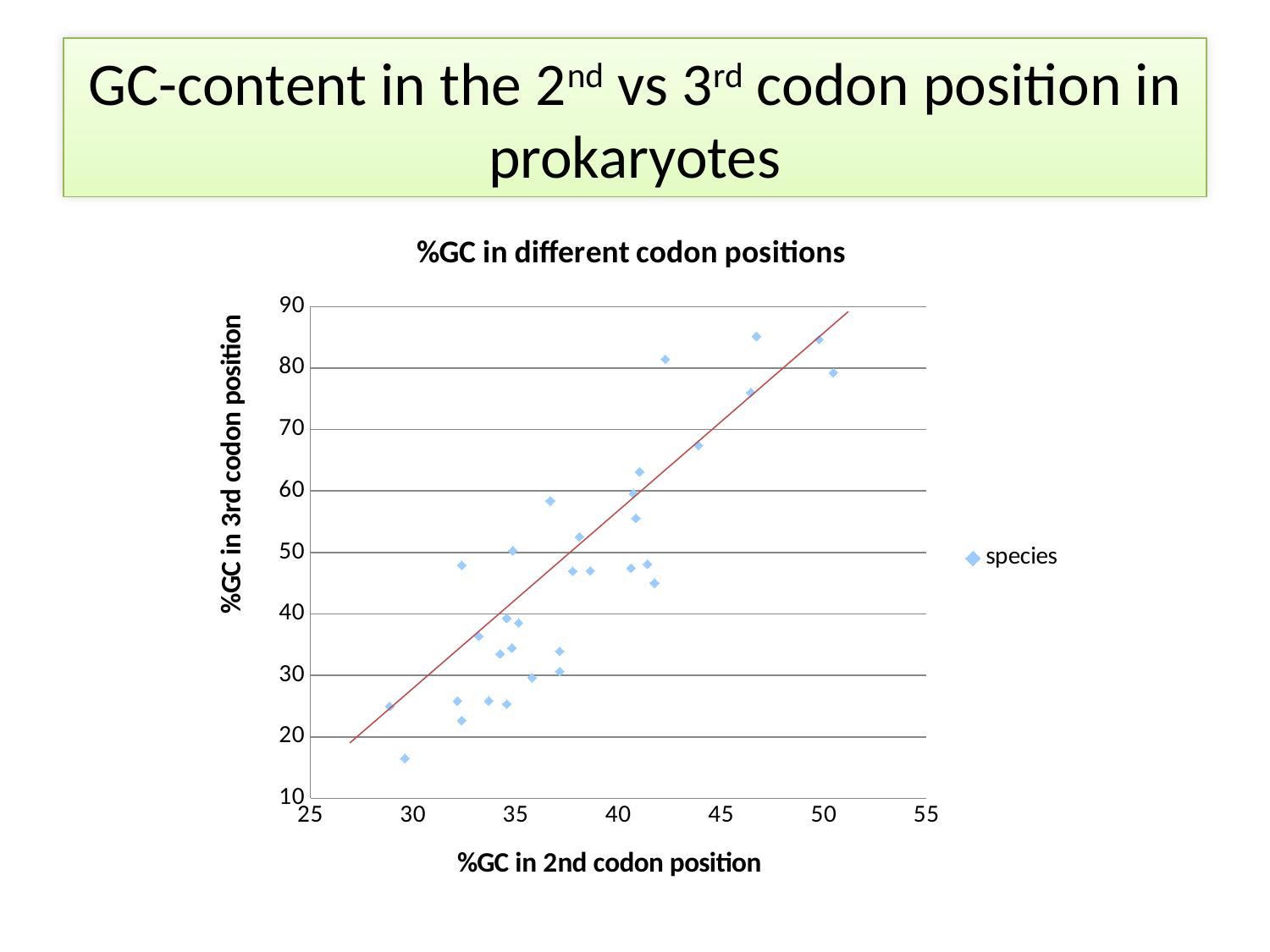
Is the smallest %GC in 2nd codon position value among the plotted points greater or less than 30? less How many series does the legend list? 1 Is the highest plotted %GC in 3rd codon position value greater or less than 80? greater As %GC in the 2nd codon position increases along the x axis, do the values of %GC in the 3rd codon position generally rise or fall? rise What is the name of the series shown in the legend? species Is the lowest plotted %GC in 3rd codon position value greater or less than 20? less What kind of chart is shown on the slide? scatter plot What is the title of the chart? %GC in different codon positions